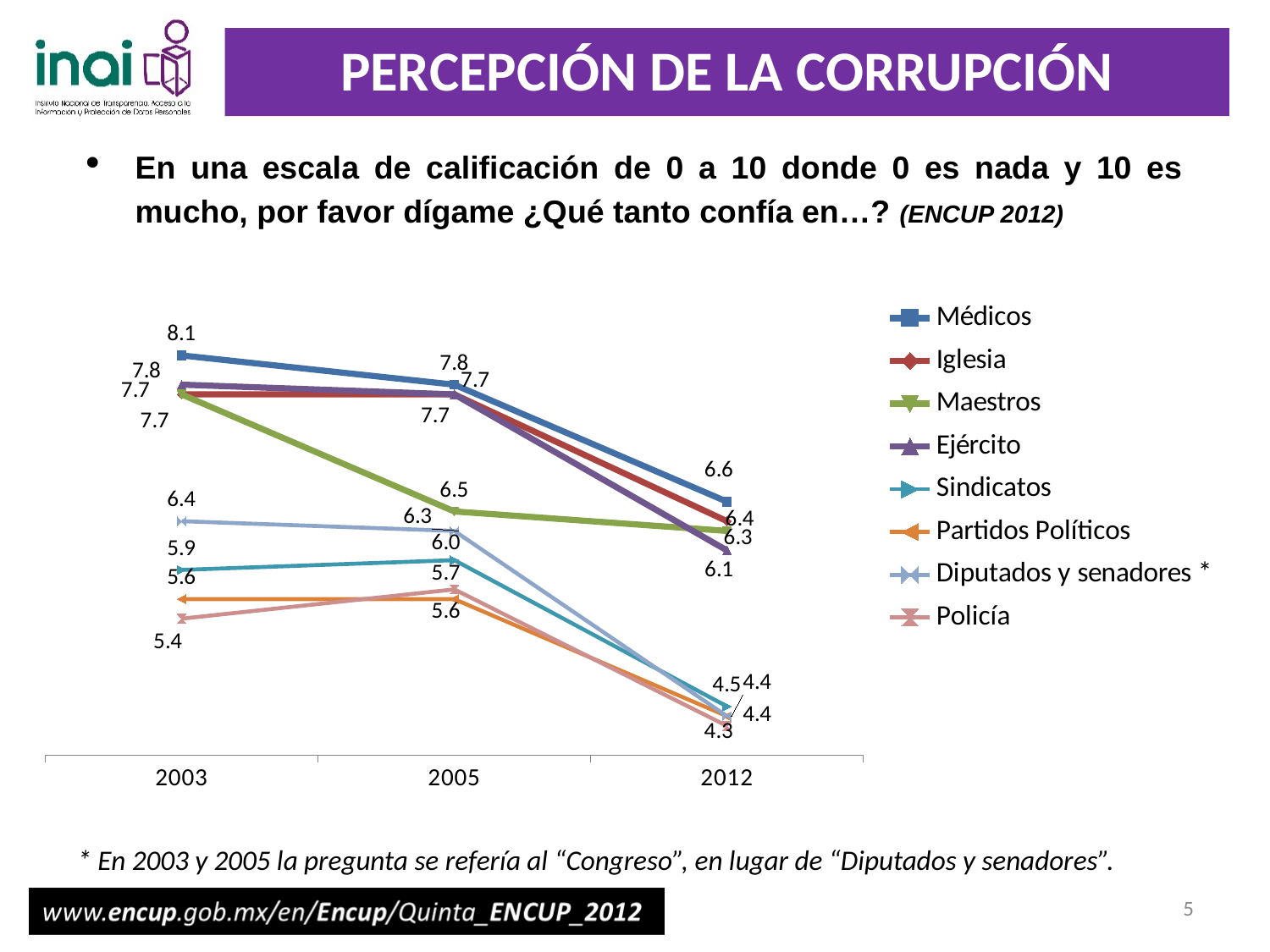
How many series does the legend list? 8 Which series has the highest value in 2003? Médicos What is the value for Policía in 2003? 5.4 Which series has the lowest value in 2003? Policía How many years are shown on the x axis? 3 What is the value for Médicos in 2003? 8.1 What is the value for Médicos in 2012? 6.6 What kind of chart is shown on the slide? line chart What is the value for Ejército in 2012? 6.1 Does the value for Médicos rise or fall from 2003 to 2012? fall What is the value for Maestros in 2005? 6.5 By how much did the value for Médicos fall from 2003 to 2012? 1.5